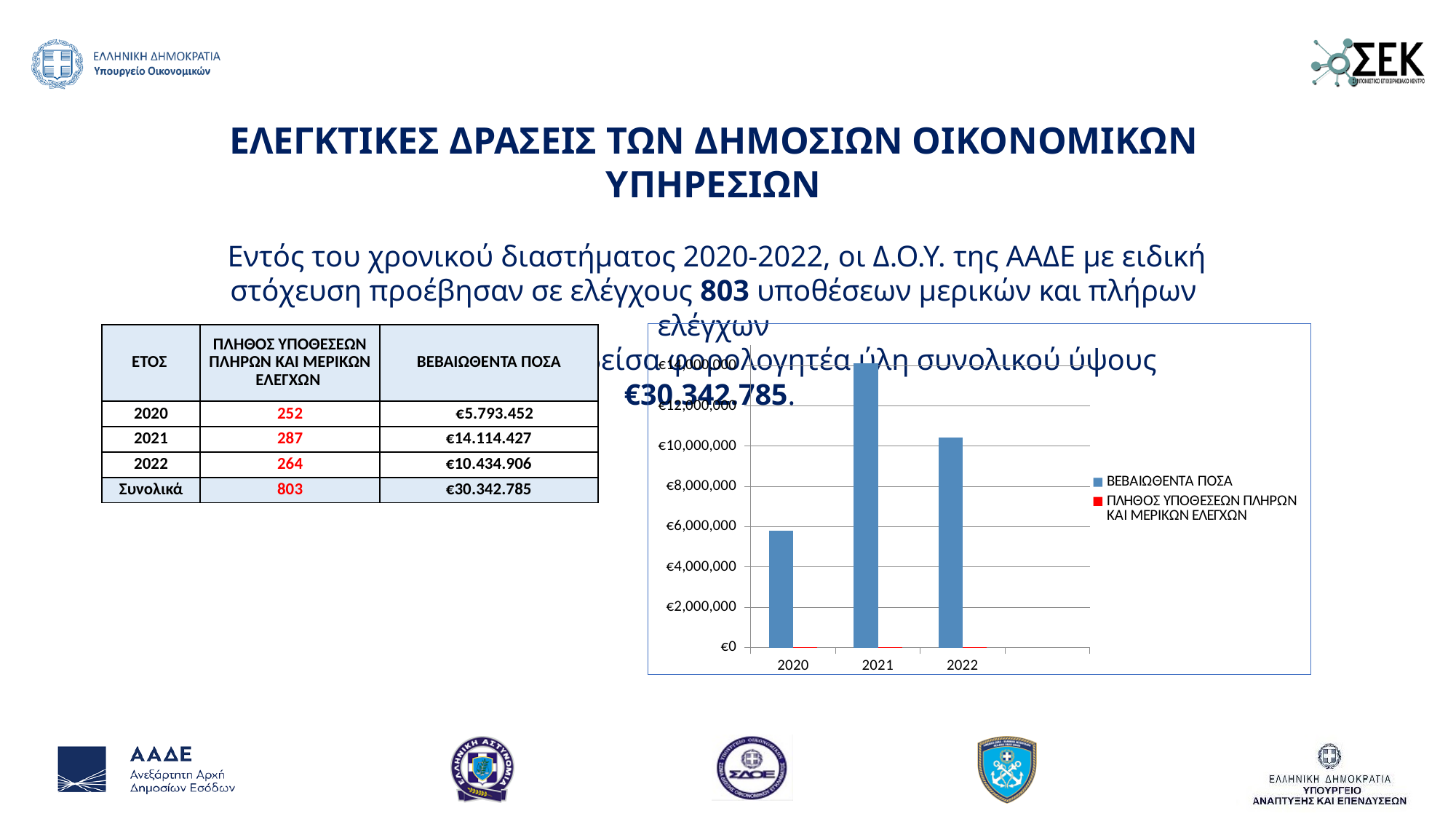
What colour are the ΒΕΒΑΙΩΘΕΝΤΑ ΠΟΣΑ bars in the chart? blue Which year has the tallest ΒΕΒΑΙΩΘΕΝΤΑ ΠΟΣΑ bar in the chart? 2021 Which year has the shortest ΒΕΒΑΙΩΘΕΝΤΑ ΠΟΣΑ bar in the chart? 2020 Is the ΒΕΒΑΙΩΘΕΝΤΑ ΠΟΣΑ value for 2020 greater or less than €4,000,000? greater What kind of chart is shown on the slide? bar chart Does the ΒΕΒΑΙΩΘΕΝΤΑ ΠΟΣΑ value rise or fall from 2021 to 2022? fall How many series does the chart legend list? 2 What is the highest value labelled on the chart's y axis? €14,000,000 Is the ΒΕΒΑΙΩΘΕΝΤΑ ΠΟΣΑ value for 2021 greater or less than €12,000,000? greater In the chart, is the ΒΕΒΑΙΩΘΕΝΤΑ ΠΟΣΑ bar for 2022 taller or shorter than the bar for 2020? taller How many years are shown on the x axis of the chart? 3 Is the ΒΕΒΑΙΩΘΕΝΤΑ ΠΟΣΑ value for 2022 greater or less than €12,000,000? less